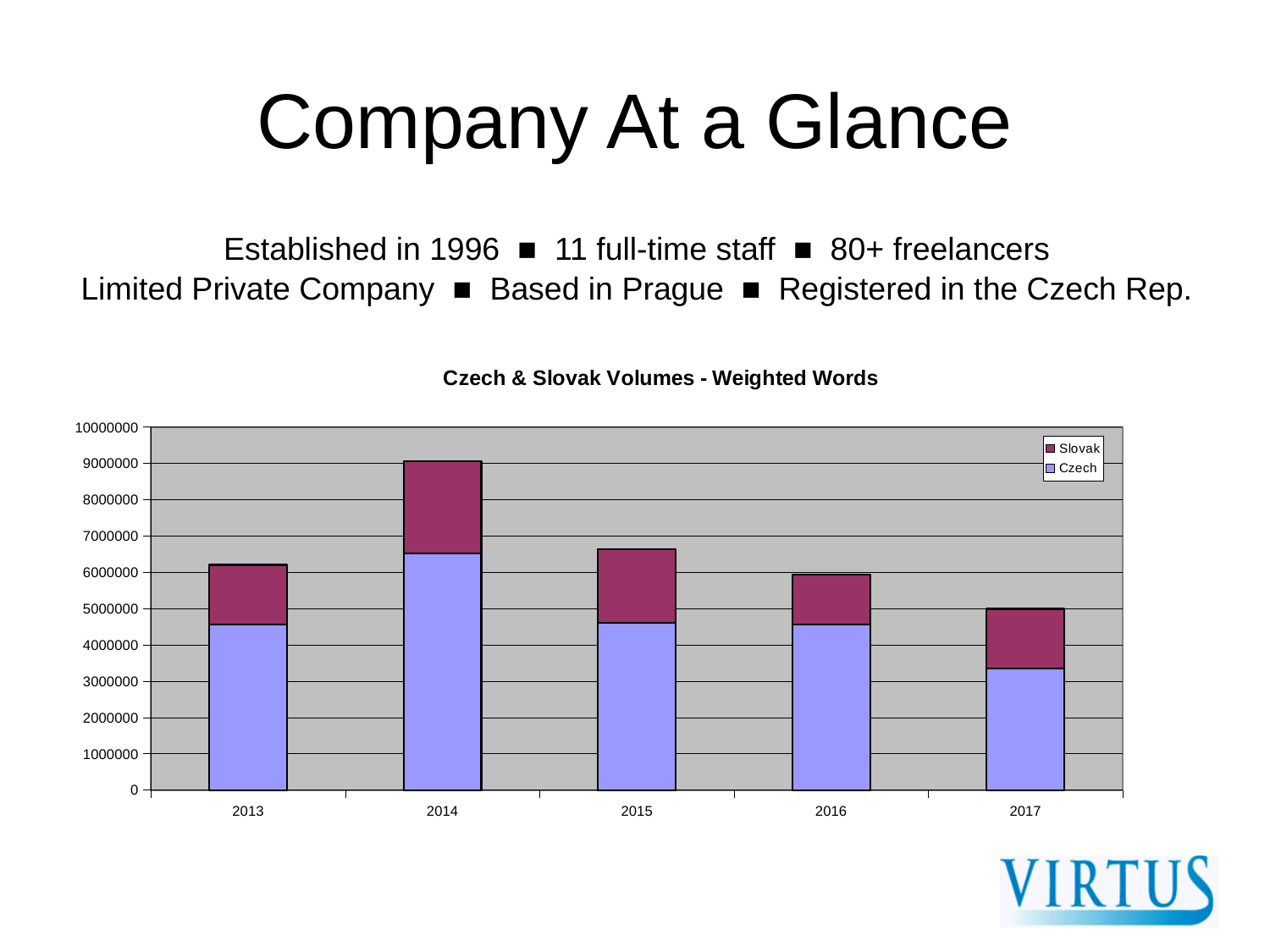
Which year has the larger total bar, 2015 or 2016? 2015 How many years are shown on the x axis of the chart? 5 Is the Czech value for 2014 greater or less than 6000000? greater Which colour represents the Slovak series in the chart? Dark red (maroon) Which year has the lowest total stacked bar? 2017 Which year has the highest total stacked bar? 2014 What is the title of the chart? Czech & Slovak Volumes - Weighted Words Do the total bars rise or fall from 2014 to 2017? fall What kind of chart is shown on the slide? Stacked bar chart How many series does the chart's legend list? 2 Is the Czech value for 2017 greater or less than 4000000? less